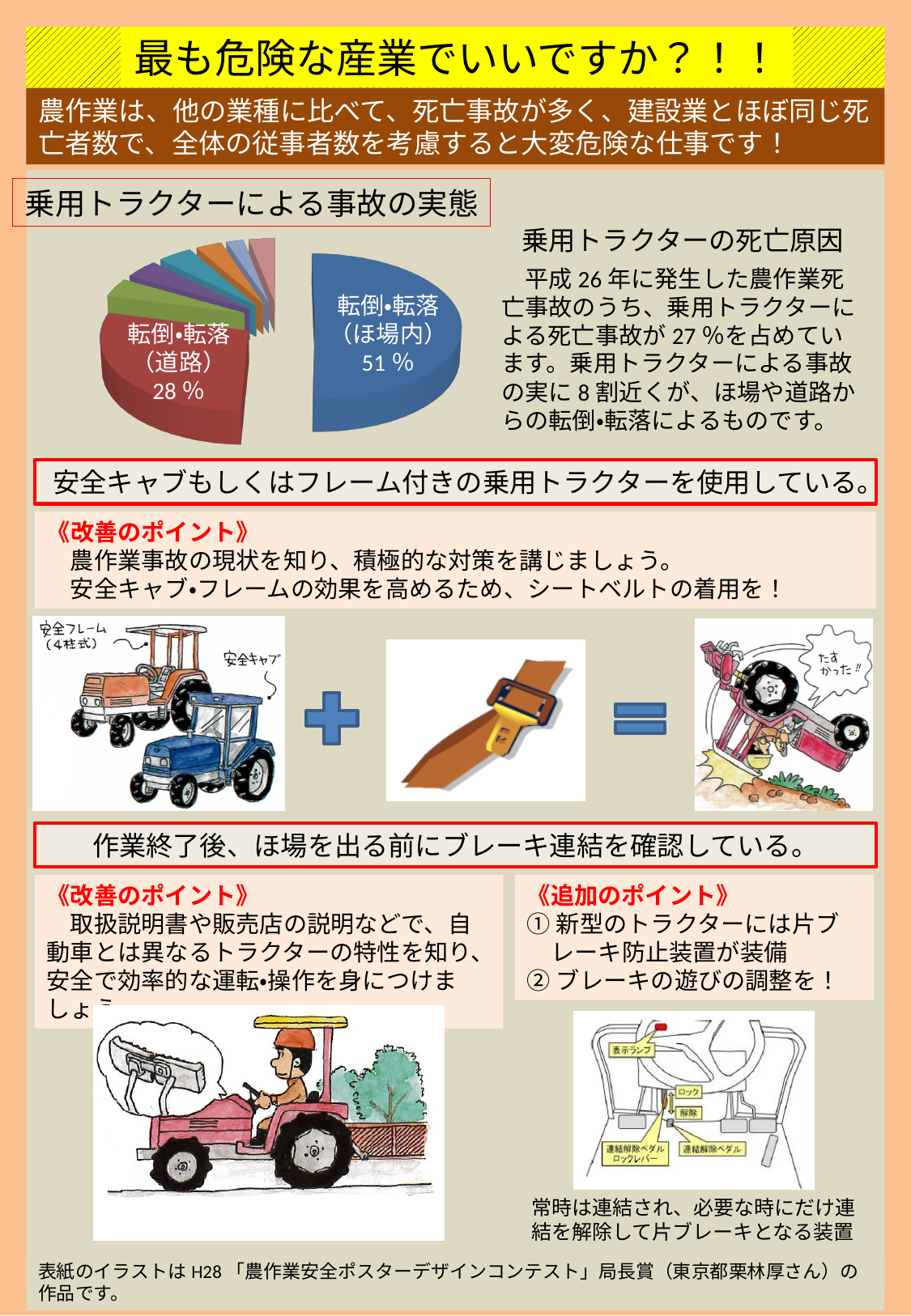
What kind of chart is shown on the slide? Pie chart What percentage does the 転倒•転落（道路） slice of the pie chart represent? 28 % What colour is the 転倒•転落（道路） slice of the pie chart? Red What is the difference in percentage points between the 転倒•転落（ほ場内） slice and the 転倒•転落（道路） slice? 23 % What colour is the 転倒•転落（ほ場内） slice of the pie chart? Blue What percentage does the 転倒•転落（ほ場内） slice of the pie chart represent? 51 % Which labeled slice of the pie chart is the largest? 転倒•転落（ほ場内） What is the combined share of the two labeled slices, 転倒•転落（ほ場内） and 転倒•転落（道路）? 79 % Is the share of the 転倒•転落（ほ場内） slice greater or less than 50%? greater Which is larger in the pie chart: 転倒•転落（ほ場内） or 転倒•転落（道路）? 転倒•転落（ほ場内）